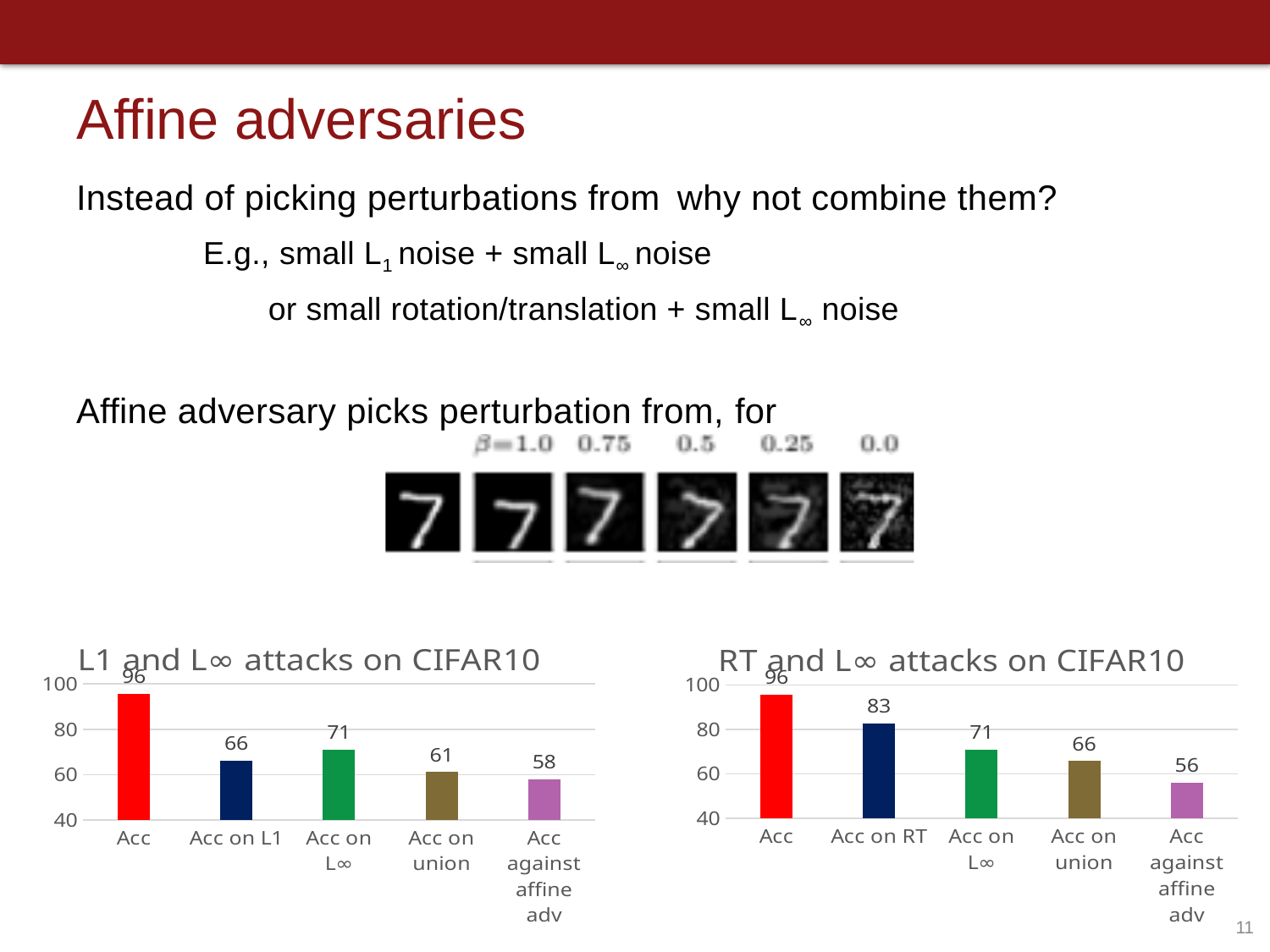
In the 'L1 and L∞ attacks on CIFAR10' chart, what is the difference between 'Acc' and 'Acc on union'? 35 In the 'RT and L∞ attacks on CIFAR10' chart, do the values rise or fall from left to right? Fall In the 'RT and L∞ attacks on CIFAR10' chart, what is the value for 'Acc on union'? 66 In the 'L1 and L∞ attacks on CIFAR10' chart, which is larger: 'Acc on L1' or 'Acc on L∞'? Acc on L∞ In the 'L1 and L∞ attacks on CIFAR10' chart, what is the value for 'Acc against affine adv'? 58 How many categories are shown in the 'RT and L∞ attacks on CIFAR10' chart? 5 In the 'RT and L∞ attacks on CIFAR10' chart, what is the value for 'Acc on RT'? 83 What kind of chart is the 'L1 and L∞ attacks on CIFAR10' chart? Bar chart In the 'RT and L∞ attacks on CIFAR10' chart, what is the difference between 'Acc on RT' and 'Acc against affine adv'? 27 In the 'L1 and L∞ attacks on CIFAR10' chart, what is the value for 'Acc on L1'? 66 In the 'RT and L∞ attacks on CIFAR10' chart, which category has the highest value? Acc In the 'L1 and L∞ attacks on CIFAR10' chart, which category has the lowest value? Acc against affine adv